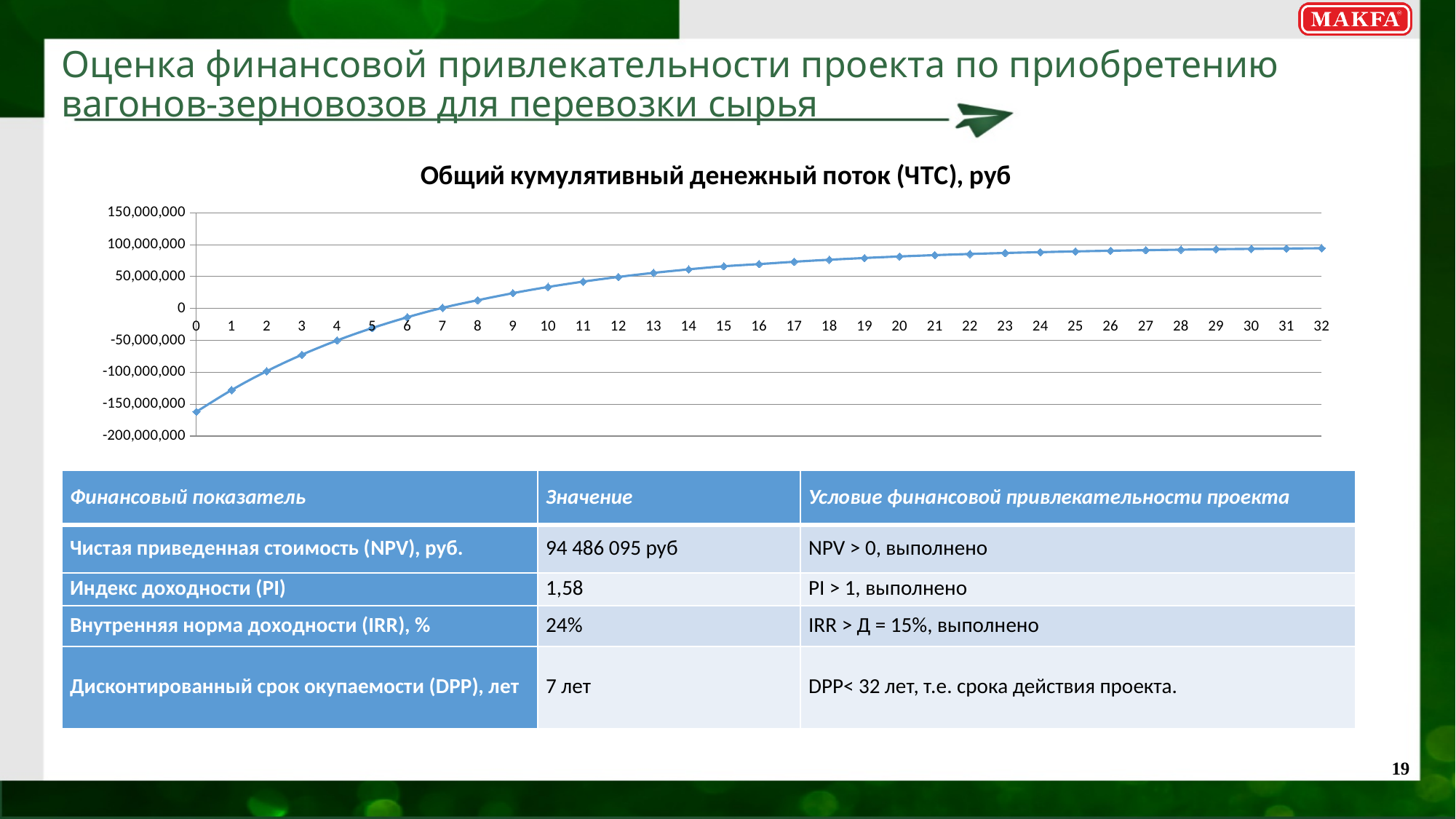
At which x-axis point is the plotted value highest? 32 Which is larger, the value at x = 5 or the value at x = 15? x = 15 Is the value at x = 3 greater or less than -50,000,000? less At which x-axis point is the plotted value lowest? 0 Is the value at x = 10 greater or less than 0? greater Is the value at x = 20 greater or less than 50,000,000? greater Do the values on the chart rise or fall as the x axis goes from 0 to 32? rise What kind of chart is shown on the slide? line chart What is the title of the chart? Общий кумулятивный денежный поток (ЧТС), руб How many data points are plotted on the chart? 33